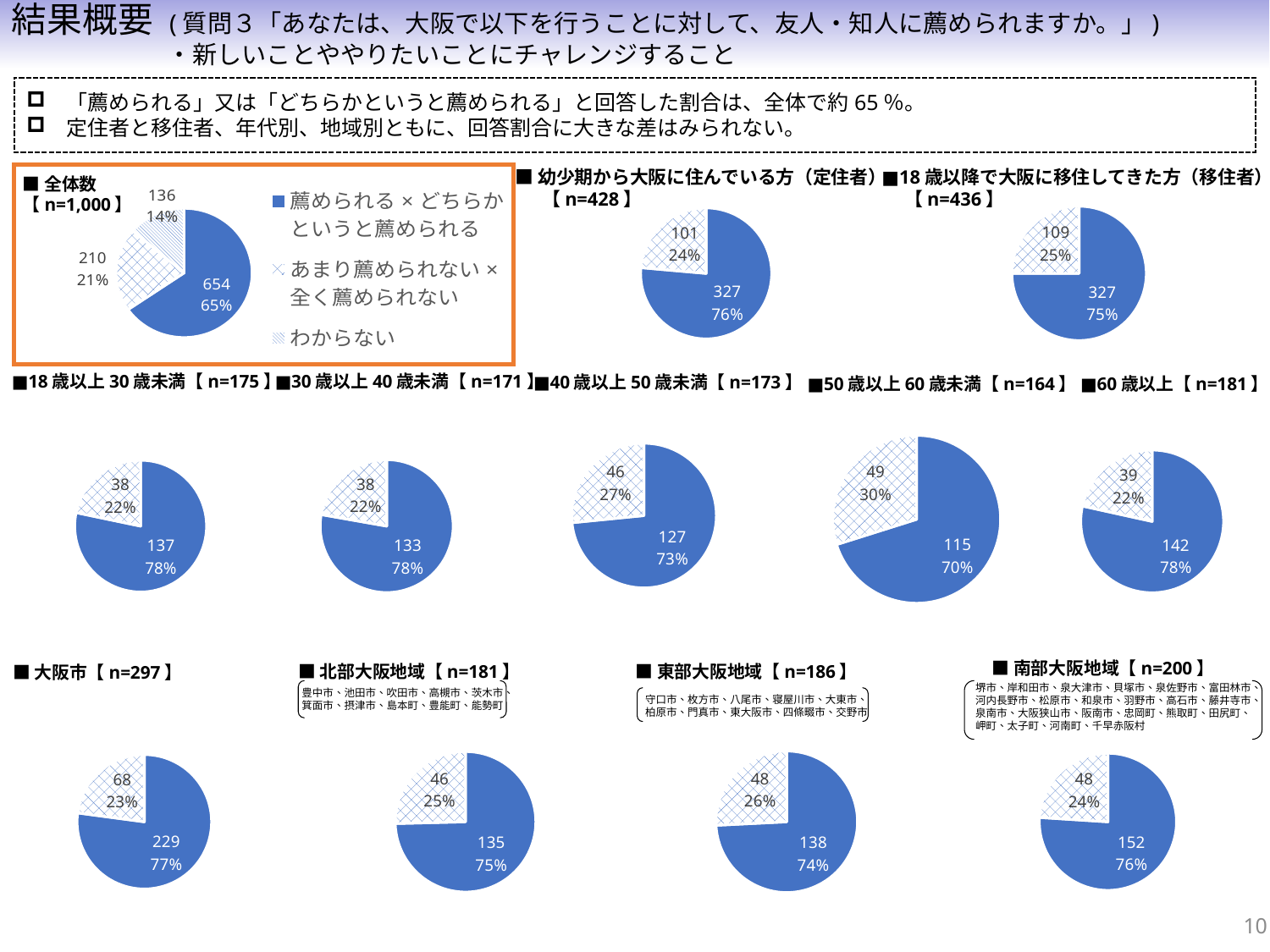
Which pie chart shows a larger value for its largest slice: 大阪市【n=297】 or 南部大阪地域【n=200】? 大阪市【n=297】 How many slices does the 北部大阪地域【n=181】 pie chart have? 2 In the 全体数【n=1,000】 pie chart, what is the value for 薦められる×どちらかというと薦められる? 654 What kind of chart is used for 全体数【n=1,000】? Pie chart In the 東部大阪地域【n=186】 pie chart, what percentage is shown for the smaller slice? 26% In the 50歳以上60歳未満【n=164】 pie chart, what is the difference between the two slice values (115 and 49)? 66 In the 60歳以上【n=181】 pie chart, what is the value of the larger slice? 142 In the 18歳以降で大阪に移住してきた方（移住者）【n=436】 pie chart, what percentage is shown for the larger slice? 75% How many entries does the legend of the 全体数【n=1,000】 pie chart list? 3 In the 幼少期から大阪に住んでいる方（定住者）【n=428】 pie chart, what is the value of the smaller slice? 101 In the 全体数【n=1,000】 pie chart, what share of the pie is わからない? 14% In the 全体数【n=1,000】 pie chart, which category is the smallest? わからない